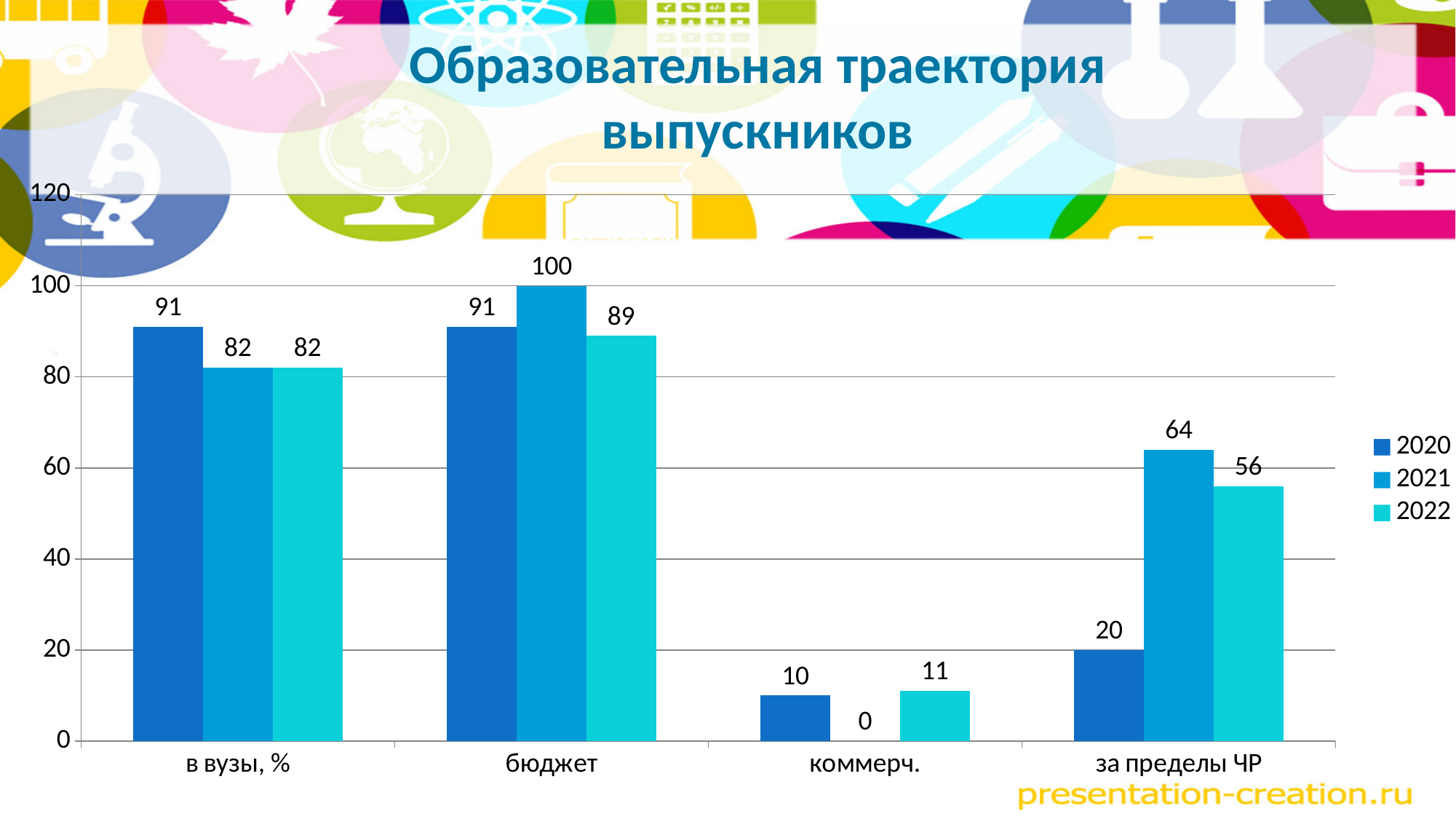
What is the value for 2021 in the "бюджет" category? 100 How many series does the legend list? 3 What is the value for 2022 in the "коммерч." category? 11 Which is larger in the "бюджет" category: the 2020 value or the 2022 value? 2020 What kind of chart is shown on the slide? bar chart Which category has the lowest value for the 2021 series? коммерч. How many categories are shown on the x axis? 4 What is the difference between the 2020 and 2021 values in the "в вузы, %" category? 9 What is the difference between the 2021 and 2022 values in the "за пределы ЧР" category? 8 What is the value for 2020 in the "за пределы ЧР" category? 20 Which category has the highest value for the 2020 series? в вузы, % and бюджет (tied at 91) What is the title of the slide? Образовательная траектория выпускников